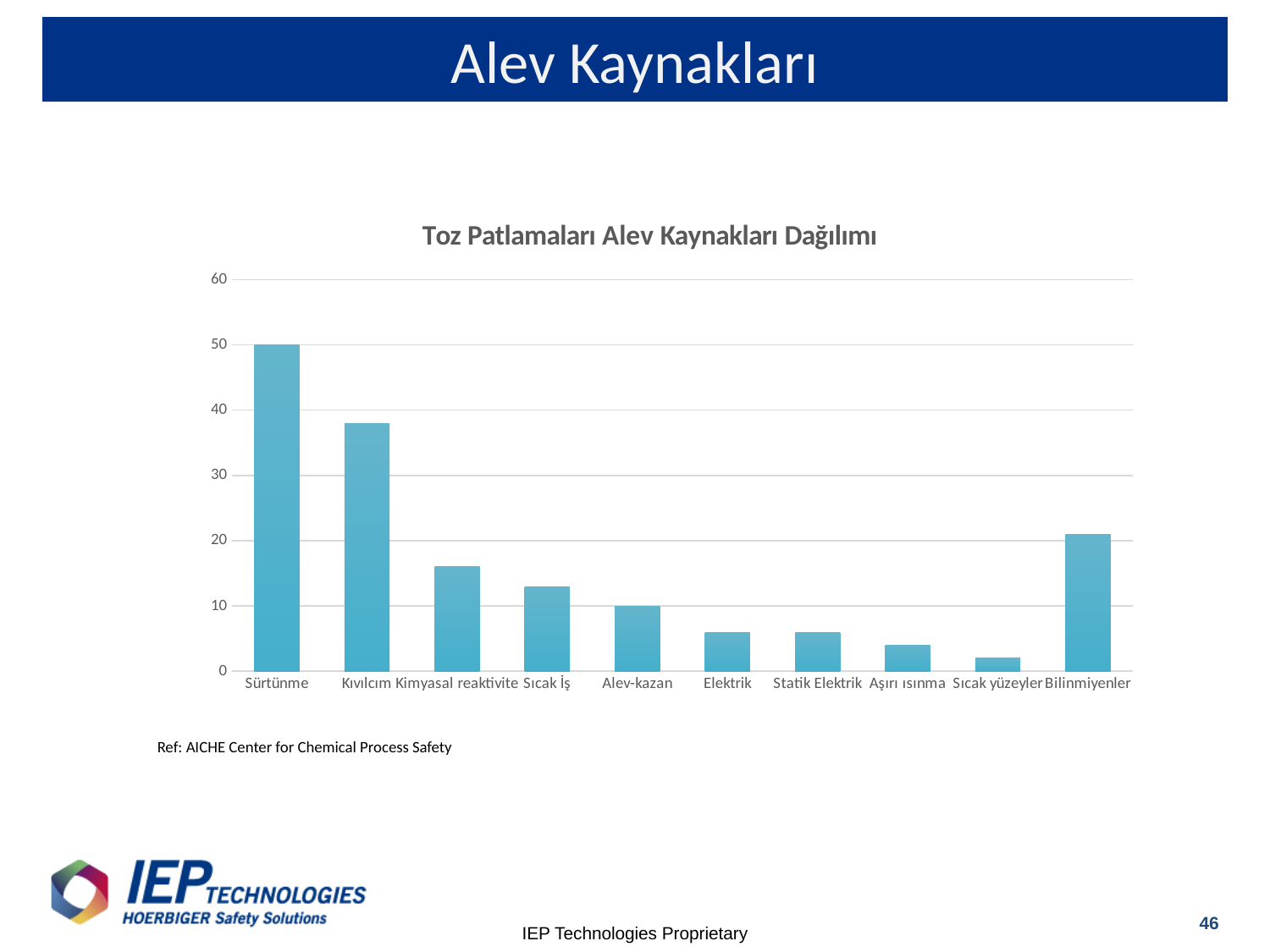
Which category has the lowest value in the chart? Sıcak yüzeyler What is the value for Alev-kazan? 10 What is the title of the chart? Toz Patlamaları Alev Kaynakları Dağılımı Is the value for Kimyasal reaktivite greater or less than 20? less What type of chart is shown on the slide? Bar chart Which is larger, the value for Kıvılcım or the value for Bilinmiyenler? Kıvılcım Is the value for Bilinmiyenler greater or less than 30? less Is the value for Kıvılcım greater or less than 30? greater How many categories are shown on the x axis of the chart? 10 Which category has the highest value in the chart? Sürtünme What is the value for Sürtünme? 50